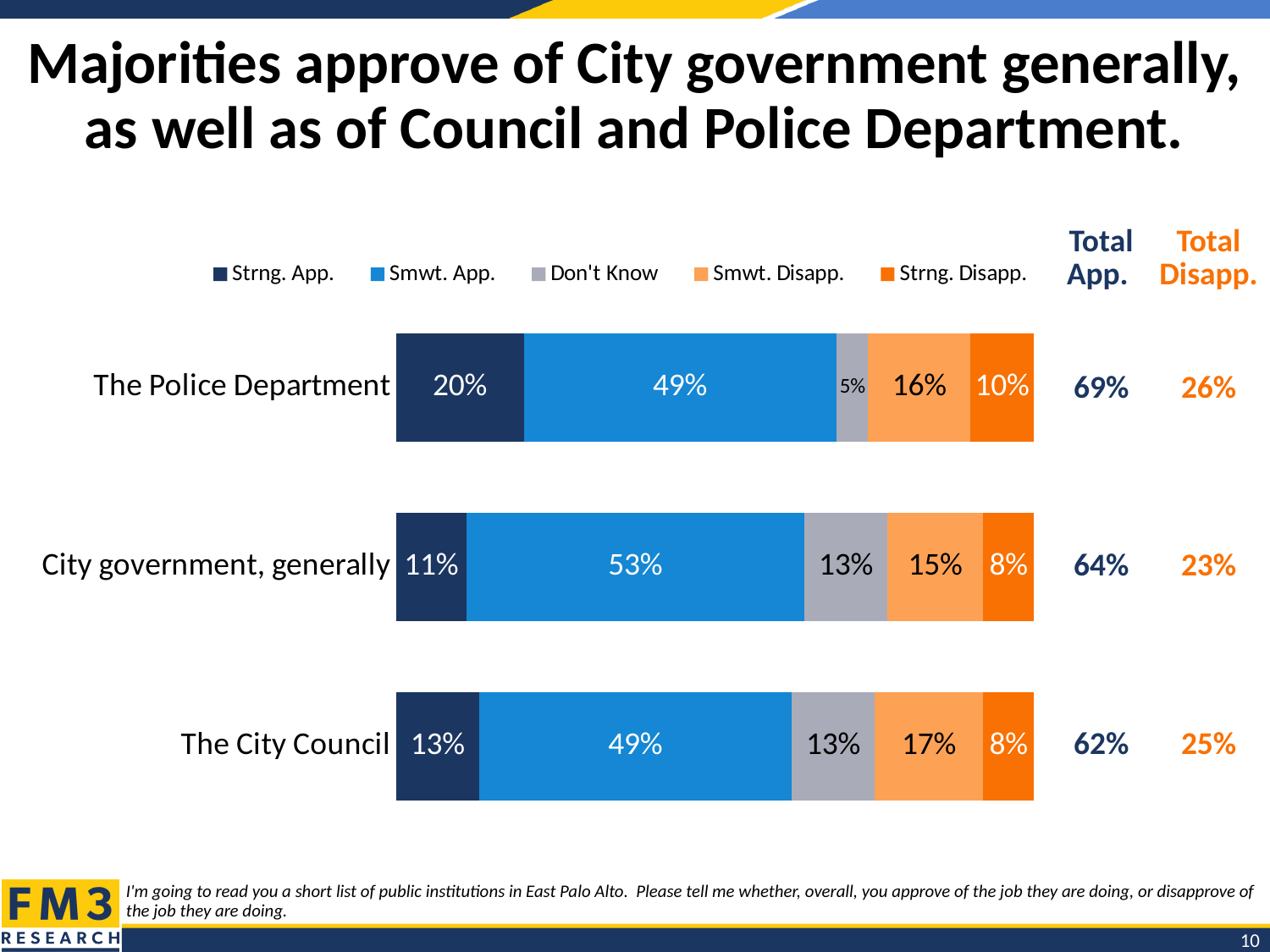
What is the Don't Know value for The City Council? 13% What is the Smwt. App. value for City government, generally? 53% Which is larger, the Smwt. App. value for City government, generally or for The City Council? City government, generally What is the Strng. Disapp. value for The Police Department? 10% What is the difference between the Smwt. Disapp. values for The City Council and City government, generally? 2% What kind of chart is shown on the slide? Stacked bar chart Which institution has the highest Strng. App. value? The Police Department What percentage strongly approve of The Police Department? 20% Which institution has the lowest Don't Know value? The Police Department How many institutions are shown in the chart? 3 How many series does the legend list? 5 What is the Total App. value shown for The City Council? 62%